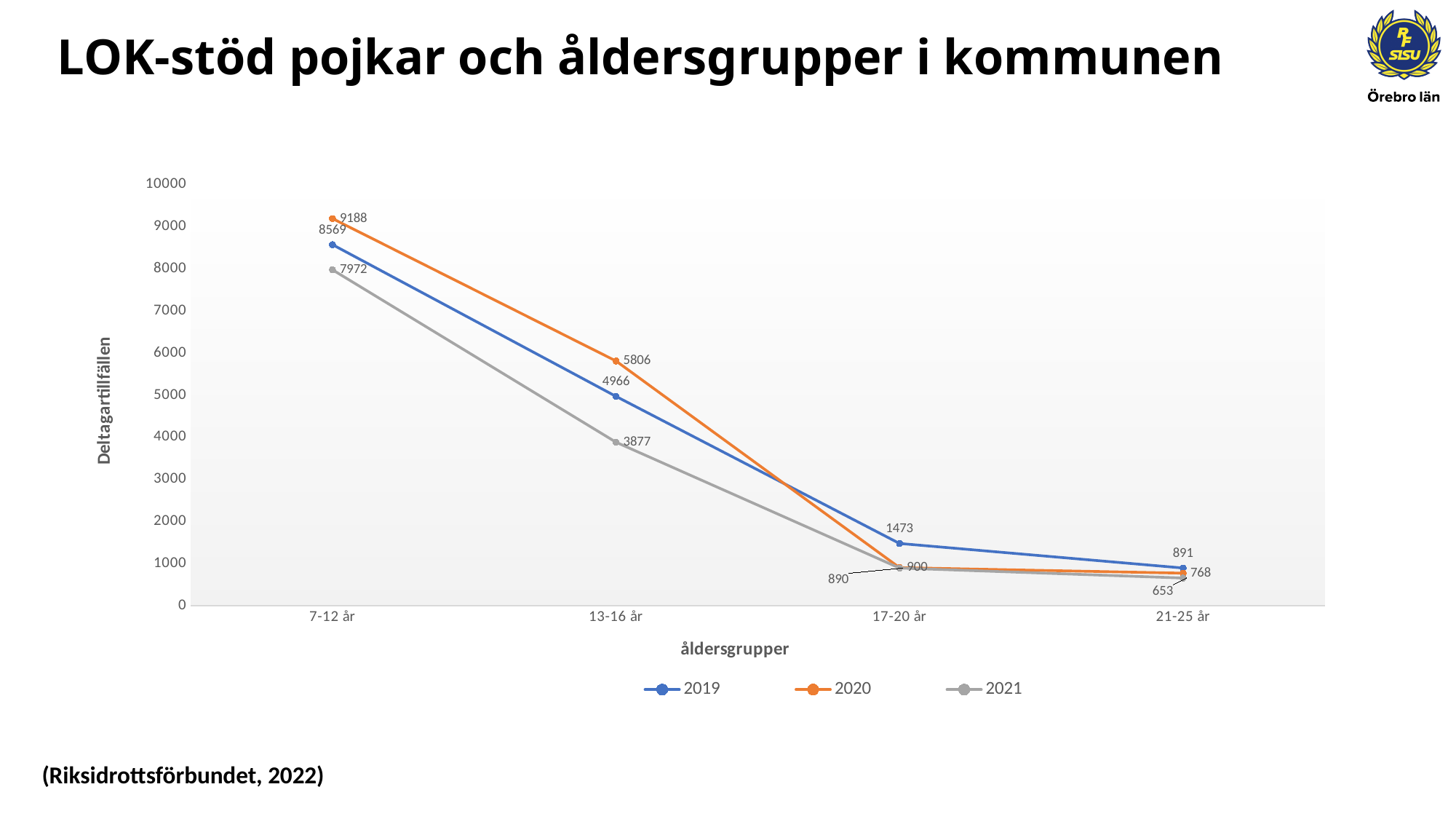
Is the value for 2020 in the 13-16 år age group greater or less than 5000? greater How many age groups are shown on the x axis? 4 Which age group has the lowest value for the 2019 series? 21-25 år Do the values for the 2019 series rise or fall from 7-12 år to 21-25 år? fall Which age group has the highest value for the 2020 series? 7-12 år What is the value for 2021 in the 21-25 år age group? 653 What is the value for 2020 in the 13-16 år age group? 5806 How many series does the legend list? 3 In the 13-16 år age group, which series has the larger value, 2019 or 2021? 2019 What kind of chart is shown on the slide? line chart What is the difference between the 2020 and 2019 values in the 7-12 år age group? 619 What is the value for 2019 in the 7-12 år age group? 8569